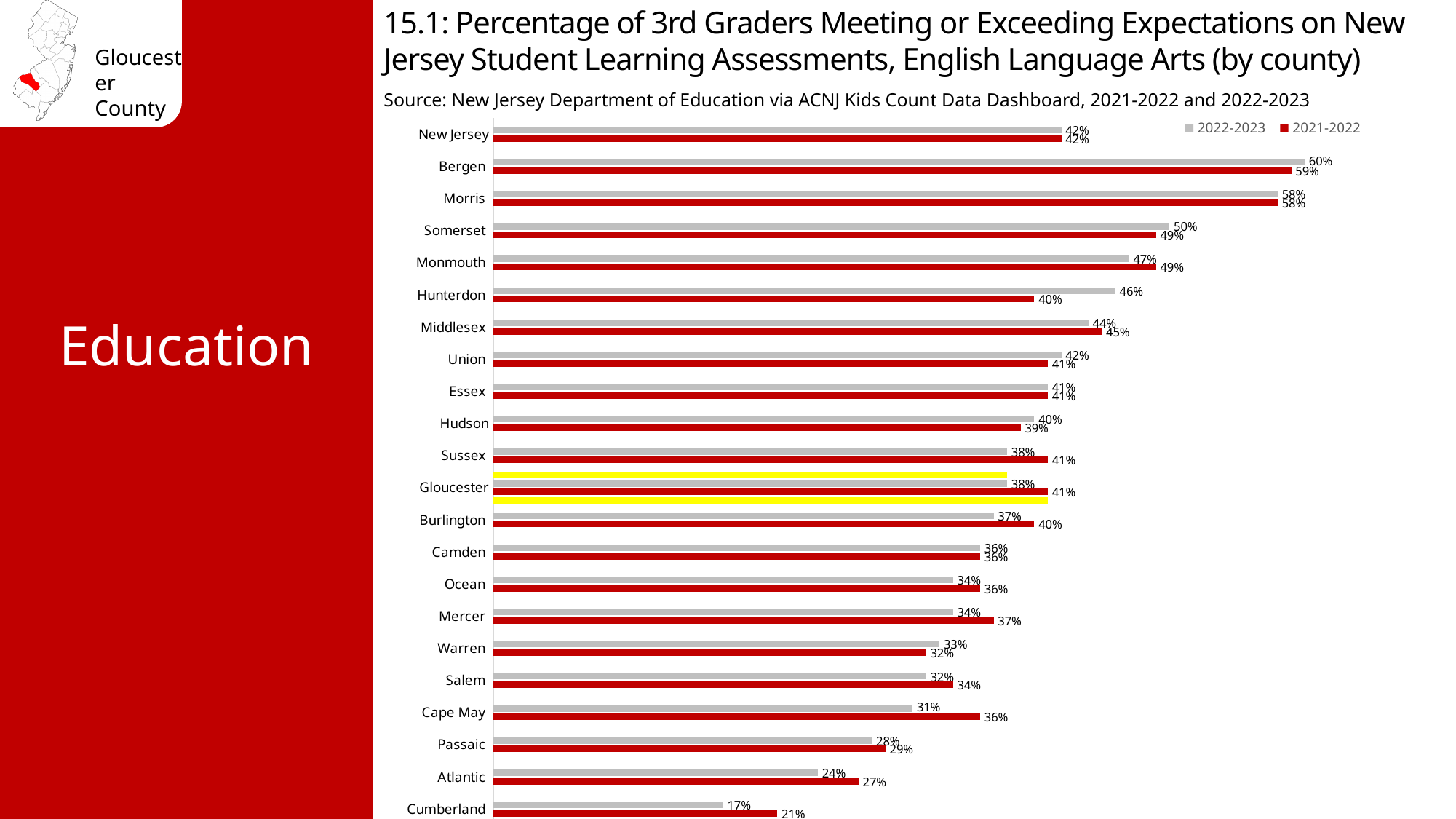
What is the difference between the 2022-2023 and 2021-2022 values for Hunterdon? 6% What is the 2022-2023 value for Gloucester? 38% What is the difference between the 2021-2022 and 2022-2023 values for Cape May? 5% What kind of chart is shown on the slide? Bar chart Which is larger for Monmouth: the 2022-2023 value or the 2021-2022 value? 2021-2022 What is the 2022-2023 value for Cape May? 31% What is the 2021-2022 value for Hunterdon? 40% Which county has the lowest 2021-2022 value? Cumberland Which county has the highest 2022-2023 value? Bergen Which county's row is highlighted in yellow on the chart? Gloucester How many series does the legend list? 2 How many categories (counties plus New Jersey) are shown on the chart? 22